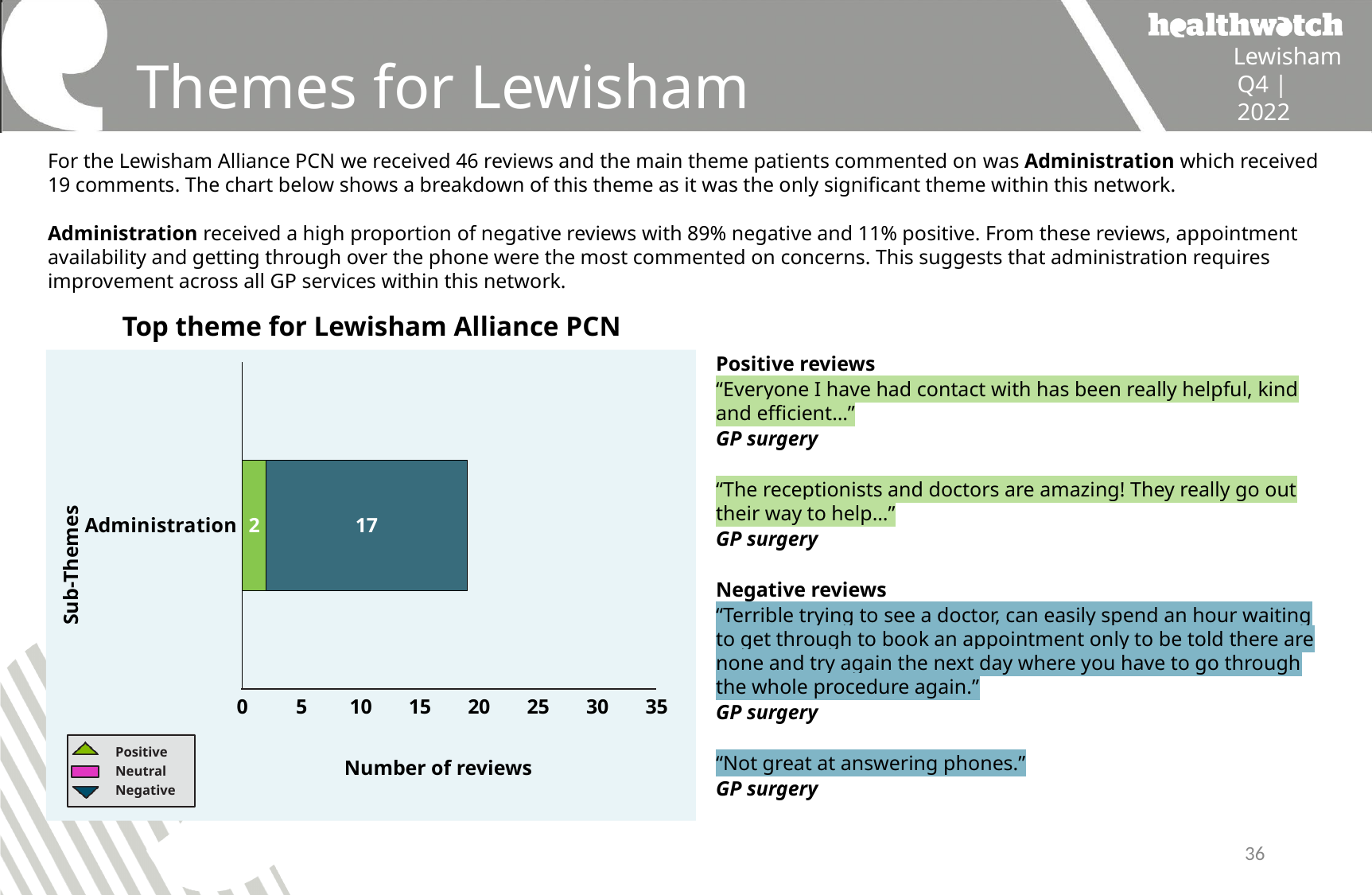
Is the total length of the Administration bar greater or less than 25? less What kind of chart is shown on the slide? bar chart What is the title of the chart? Top theme for Lewisham Alliance PCN What is the difference between the negative and positive review counts for Administration? 15 Which is larger for Administration, the positive or the negative review count? Negative How many series does the legend list? 3 How many negative reviews does the chart show for Administration? 17 How many sub-theme categories are plotted on the chart? 1 How many positive reviews does the chart show for Administration? 2 What is the total number of reviews in the Administration bar? 19 What is the label of the horizontal axis? Number of reviews